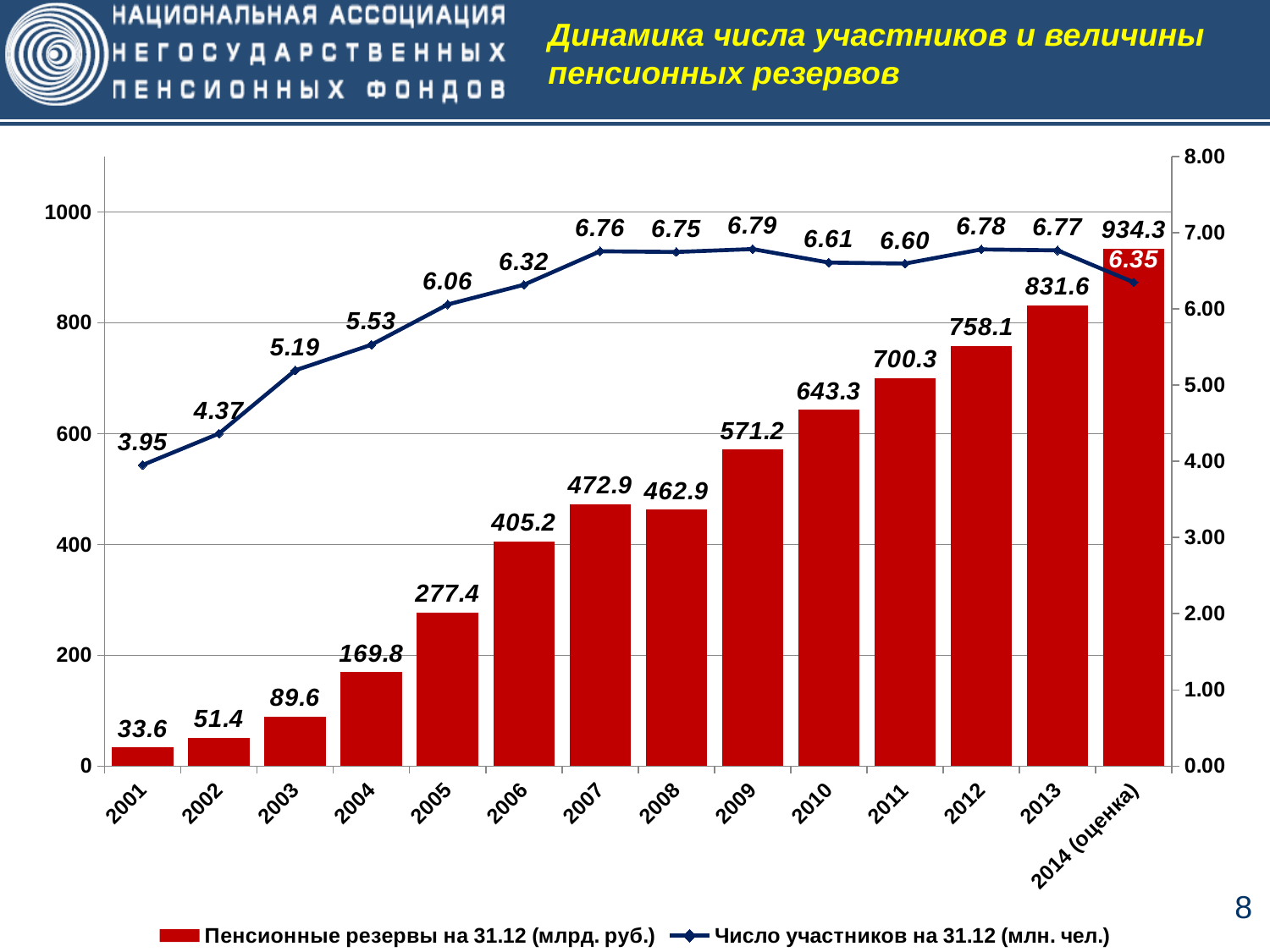
What is the value of 'Пенсионные резервы на 31.12 (млрд. руб.)' for 2009? 571.2 What kind of chart is shown on the slide? Combined bar and line chart What is the value of 'Пенсионные резервы на 31.12 (млрд. руб.)' for 2014 (оценка)? 934.3 Which year has the larger value of 'Пенсионные резервы на 31.12 (млрд. руб.)': 2007 or 2008? 2007 What is the difference in 'Пенсионные резервы на 31.12 (млрд. руб.)' between 2013 and 2012? 73.5 In which year is 'Число участников на 31.12 (млн. чел.)' the highest? 2009 In which year is 'Пенсионные резервы на 31.12 (млрд. руб.)' the lowest? 2001 What is the value of 'Число участников на 31.12 (млн. чел.)' for 2005? 6.06 How many series does the legend list? 2 How many years are shown on the x axis of the chart? 14 Is the value of 'Пенсионные резервы на 31.12 (млрд. руб.)' for 2010 greater or less than 600? greater Do the values of 'Пенсионные резервы на 31.12 (млрд. руб.)' generally rise or fall from 2001 to 2014 (оценка)? rise